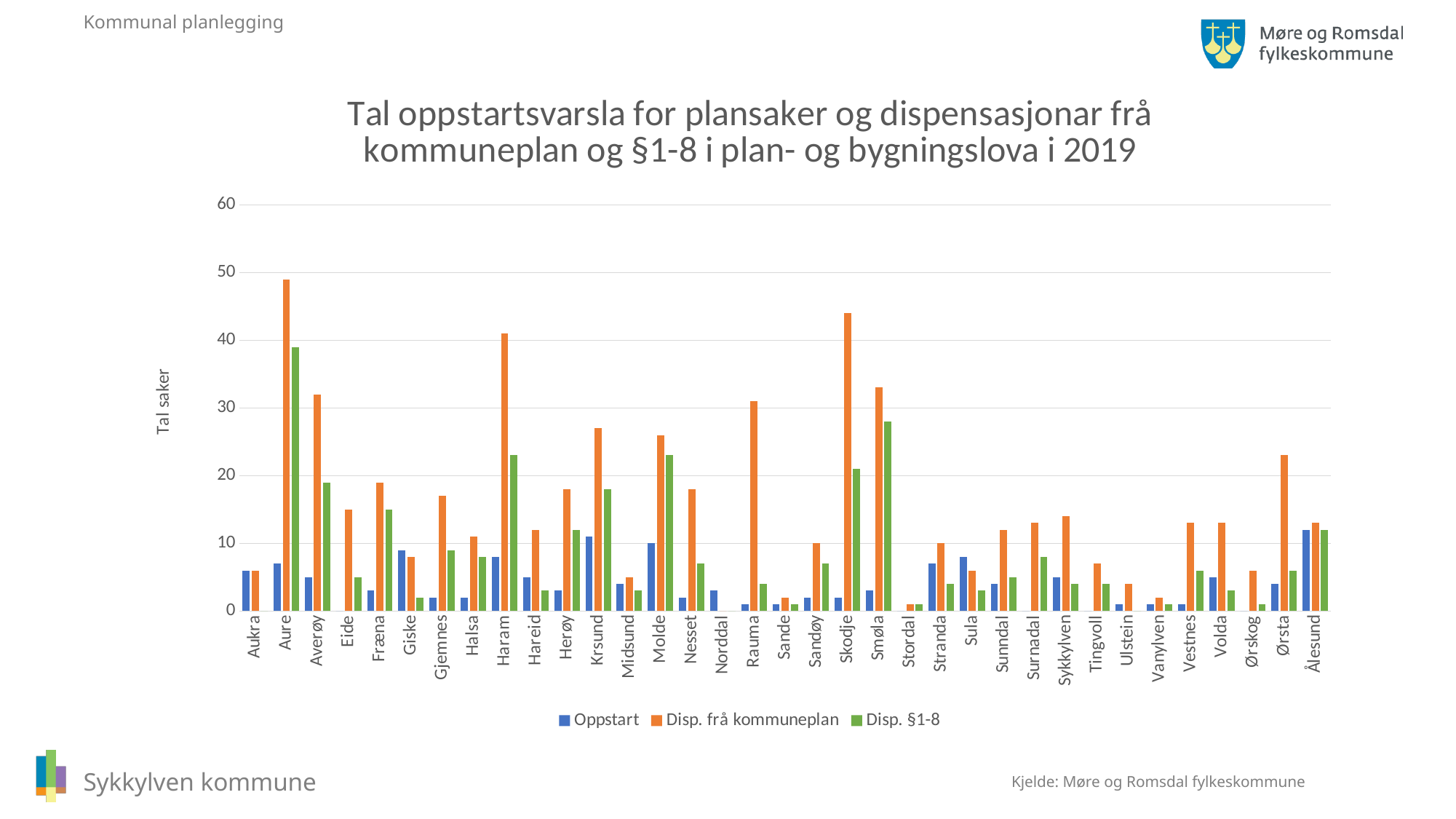
Is the Disp. frå kommuneplan value for Ørsta greater or less than 20? greater What kind of chart is shown on the slide? bar chart Is the Disp. frå kommuneplan value for Molde greater or less than 20? greater What is the label on the vertical axis of the chart? Tal saker Which municipality has the highest value for Disp. frå kommuneplan? Aure Is the Disp. frå kommuneplan value for Skodje greater or less than 40? greater Which municipality has the highest value for Disp. §1-8? Aure How many municipalities (categories) are shown on the x axis? 35 Which is larger, the Disp. §1-8 value for Smøla or for Haram? Smøla How many series does the legend list? 3 Which is larger, the Disp. frå kommuneplan value for Aure or for Skodje? Aure